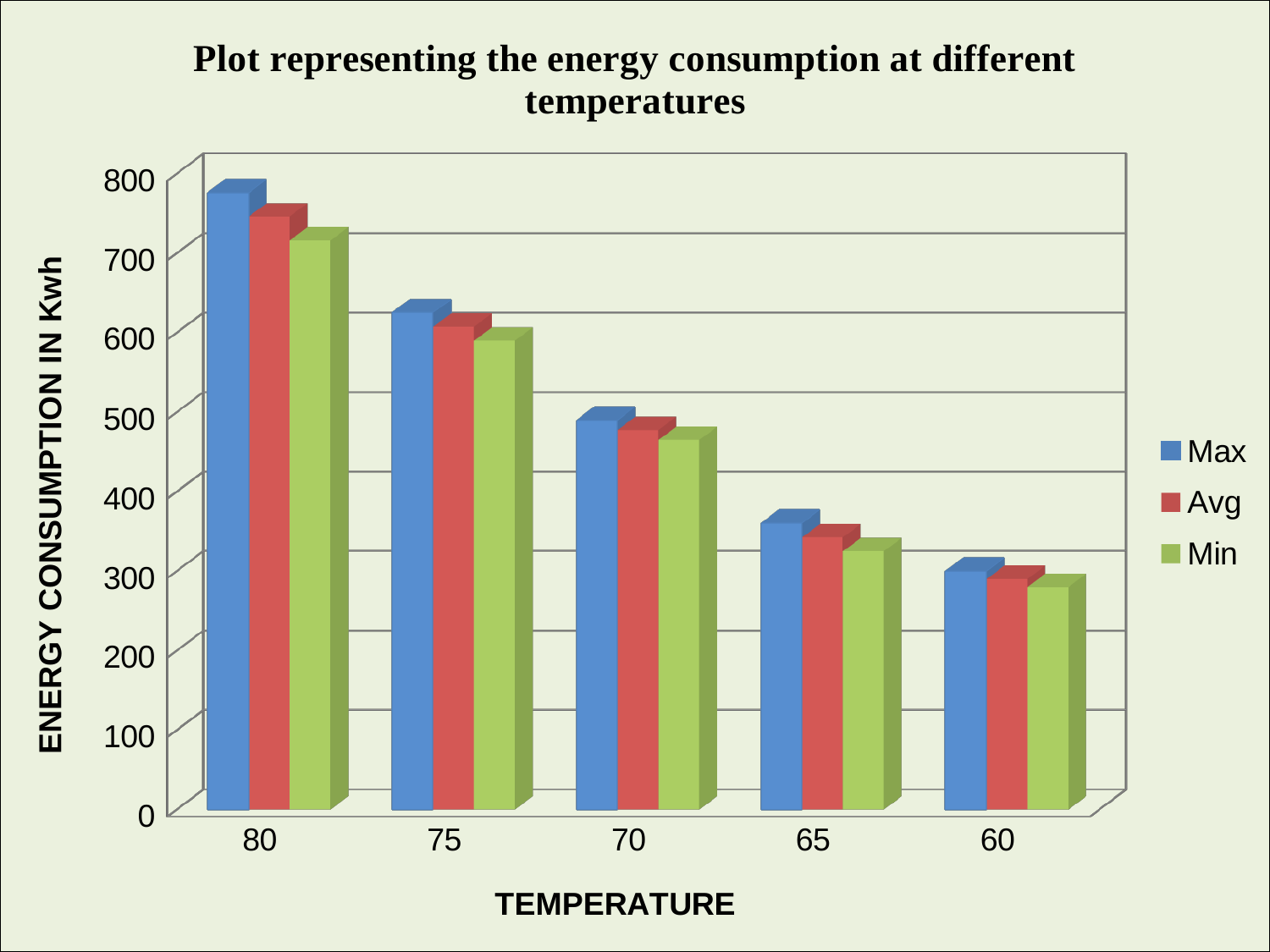
Which is larger, the Max value at temperature 75 or the Max value at temperature 65? Max at 75 Which colour represents the Avg series in the legend? red Is the Max value at temperature 80 greater or less than 700? greater Which temperature has the highest Max energy consumption? 80 Is the Avg value at temperature 70 greater or less than 400? greater Do the energy consumption values rise or fall moving from 80 to 60 along the x axis? fall What kind of chart is shown on the slide? bar chart What is the title of the chart? Plot representing the energy consumption at different temperatures Which temperature has the lowest Min energy consumption? 60 How many temperature categories are shown on the x axis? 5 How many series does the legend list? 3